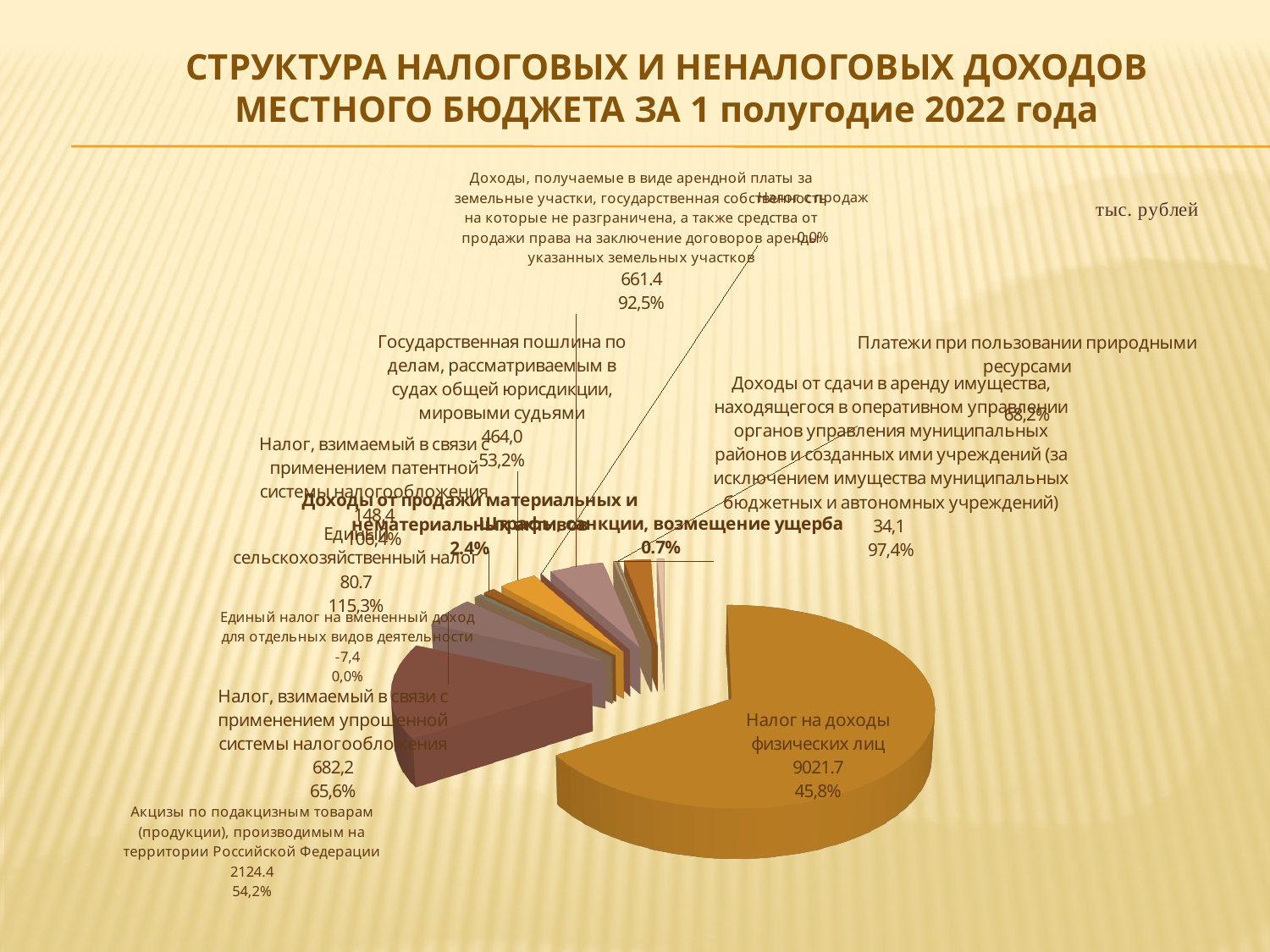
What value is shown for Единый налог на вмененный доход для отдельных видов деятельности? -7,4 What is the value shown for Акцизы по подакцизным товарам (продукции), производимым на территории Российской Федерации? 2124.4 What is the value shown for Налог, взимаемый в связи с применением упрощенной системы налогообложения? 682,2 What kind of chart is shown on the slide? pie chart Which category has the largest slice of the pie? Налог на доходы физических лиц In what units are the chart values given, according to the note on the slide? тыс. рублей What percentage is shown for Государственная пошлина по делам, рассматриваемым в судах общей юрисдикции, мировыми судьями? 53,2% What percentage is shown next to Налог на доходы физических лиц? 45,8% Which is larger: the value for Акцизы по подакцизным товарам or the value for Налог, взимаемый в связи с применением упрощенной системы налогообложения? Акцизы по подакцизным товарам What is the difference between the values for Налог на доходы физических лиц and Акцизы по подакцизным товарам? 6897.3 What is the value shown for Налог на доходы физических лиц? 9021.7 What is the value shown for Доходы от сдачи в аренду имущества, находящегося в оперативном управлении органов управления муниципальных районов и созданных ими учреждений? 34,1